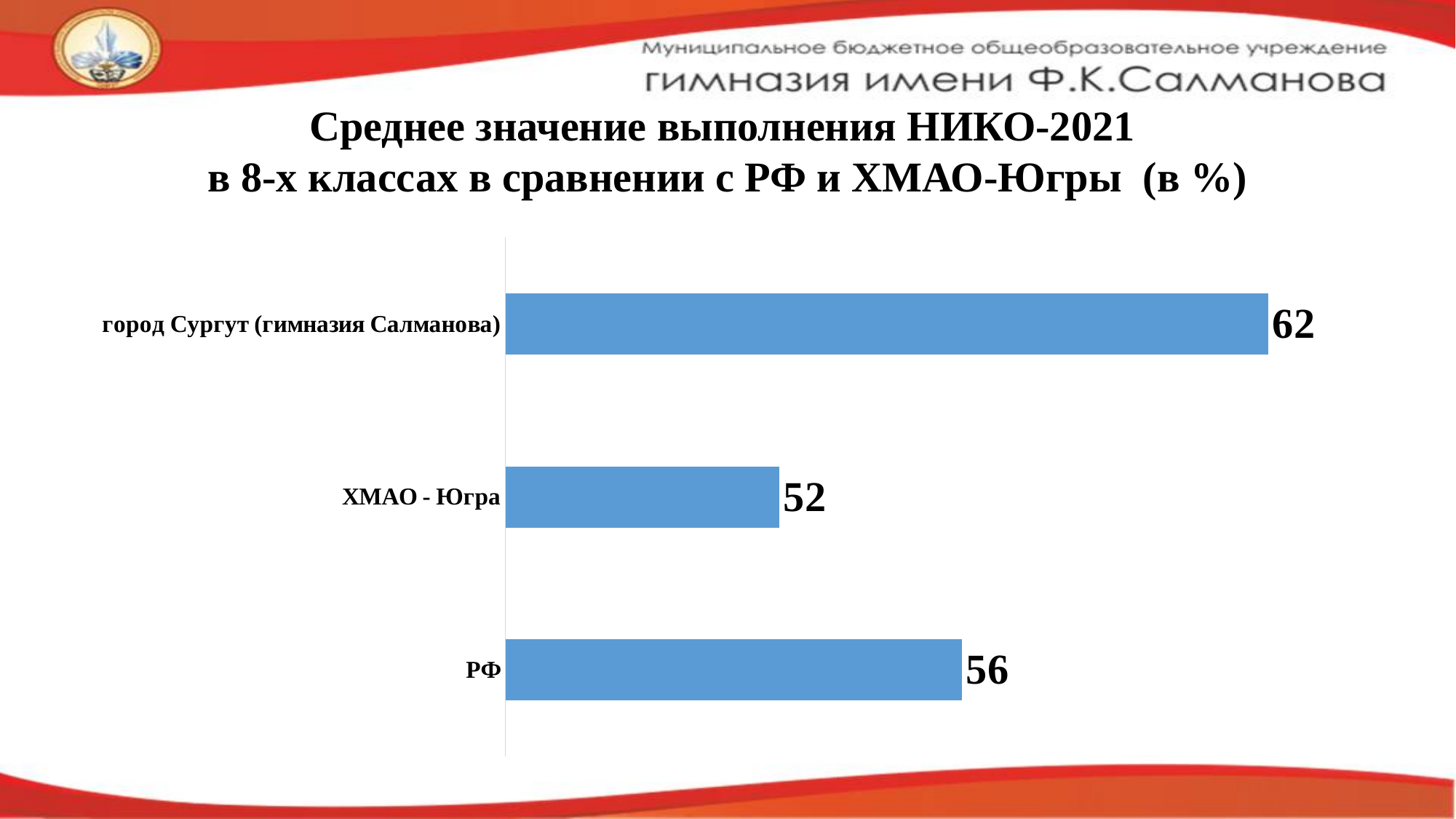
What is the value for РФ? 56 What is the difference between the values for город Сургут (гимназия Салманова) and РФ? 6 Which category has the highest value? город Сургут (гимназия Салманова) What colour are the bars in the chart? blue What kind of chart is shown on the slide? bar chart What is the value for город Сургут (гимназия Салманова)? 62 Which category has the lowest value? ХМАО - Югра How many categories are shown in the chart? 3 What is the difference between the values for РФ and ХМАО - Югра? 4 What is the value for ХМАО - Югра? 52 Which is larger, the value for РФ or the value for ХМАО - Югра? РФ What is the title of the chart on the slide? Среднее значение выполнения НИКО-2021 в 8-х классах в сравнении с РФ и ХМАО-Югры (в %)